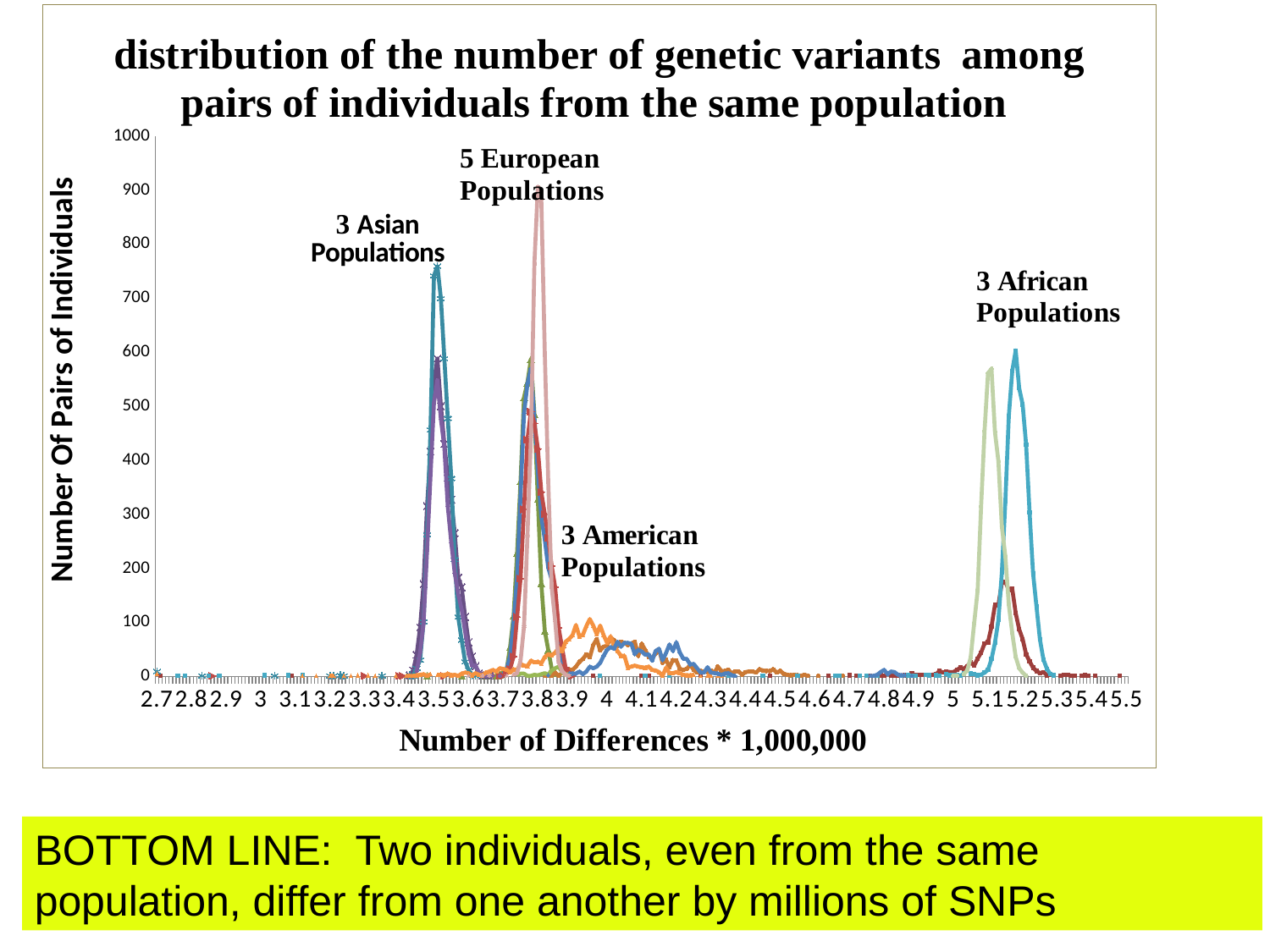
What is the title of the chart? distribution of the number of genetic variants among pairs of individuals from the same population Which labelled population group has its peaks furthest to the right on the x axis (the largest number of differences)? 3 African Populations Is the highest peak of the American populations greater or less than 200? less What kind of chart is shown on the slide? line chart What is the label of the y axis? Number Of Pairs of Individuals Is the highest peak of the Asian populations greater or less than 700? greater Which labelled population group has the highest peak on the chart? 5 European Populations How many labelled population groups are annotated on the chart? 4 Is the highest peak of the European populations greater or less than 800? greater Which has a higher peak, the Asian populations or the African populations? Asian populations Which labelled population group has the lowest peak on the chart? 3 American Populations